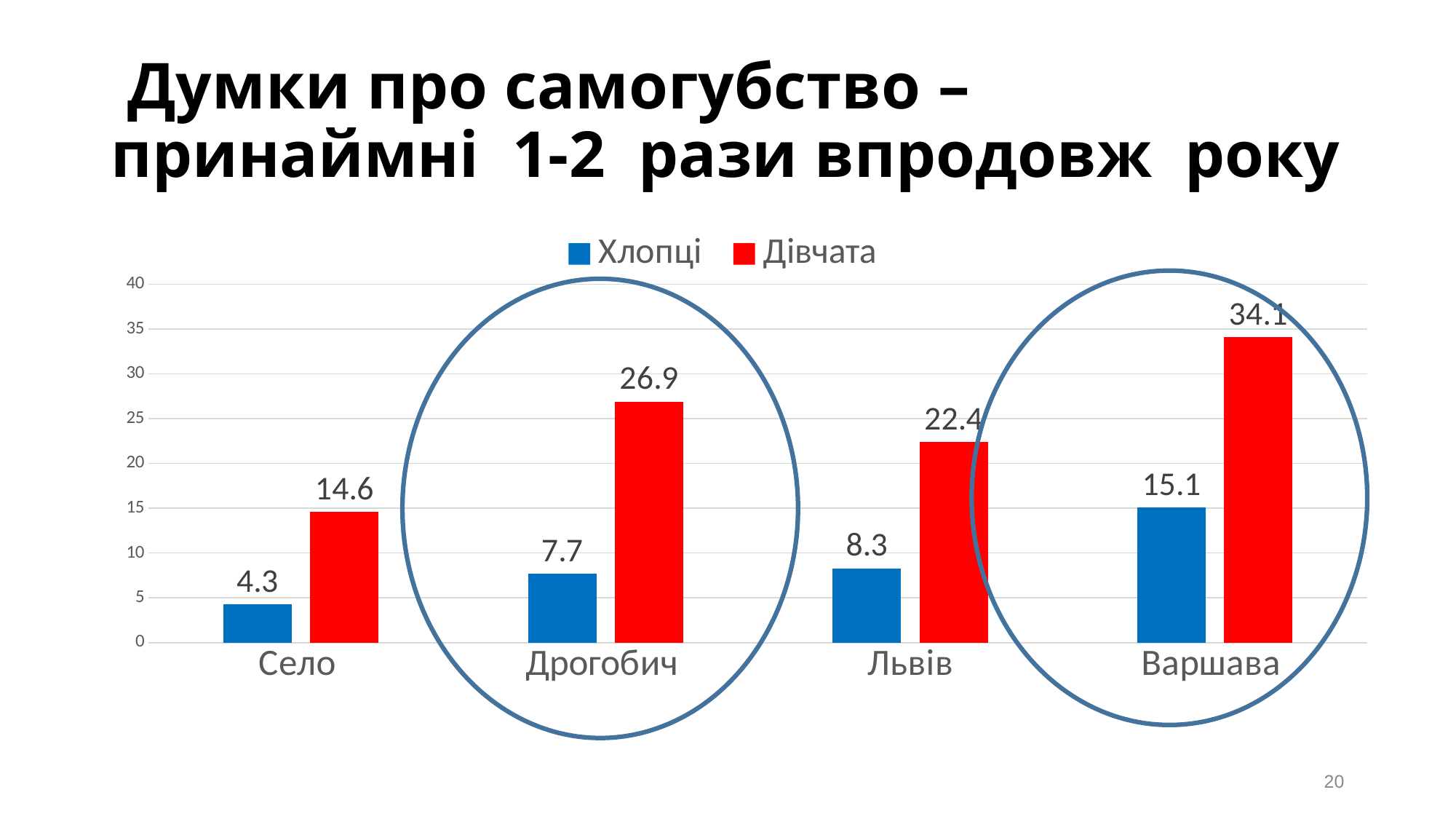
What is the value for Дівчата in Львів? 22.4 What is the value for Хлопці in Село? 4.3 How many series does the legend list? 2 What is the value for Дівчата in Варшава? 34.1 Which colour represents the Дівчата series? Red How many categories are shown on the x axis? 4 Which category has the highest value for Дівчата? Варшава Which is larger: Хлопці in Львів or Хлопці in Дрогобич? Хлопці in Львів What is the difference between Дівчата and Хлопці in Дрогобич? 19.2 What kind of chart is shown on the slide? Bar chart Which category has the lowest value for Хлопці? Село